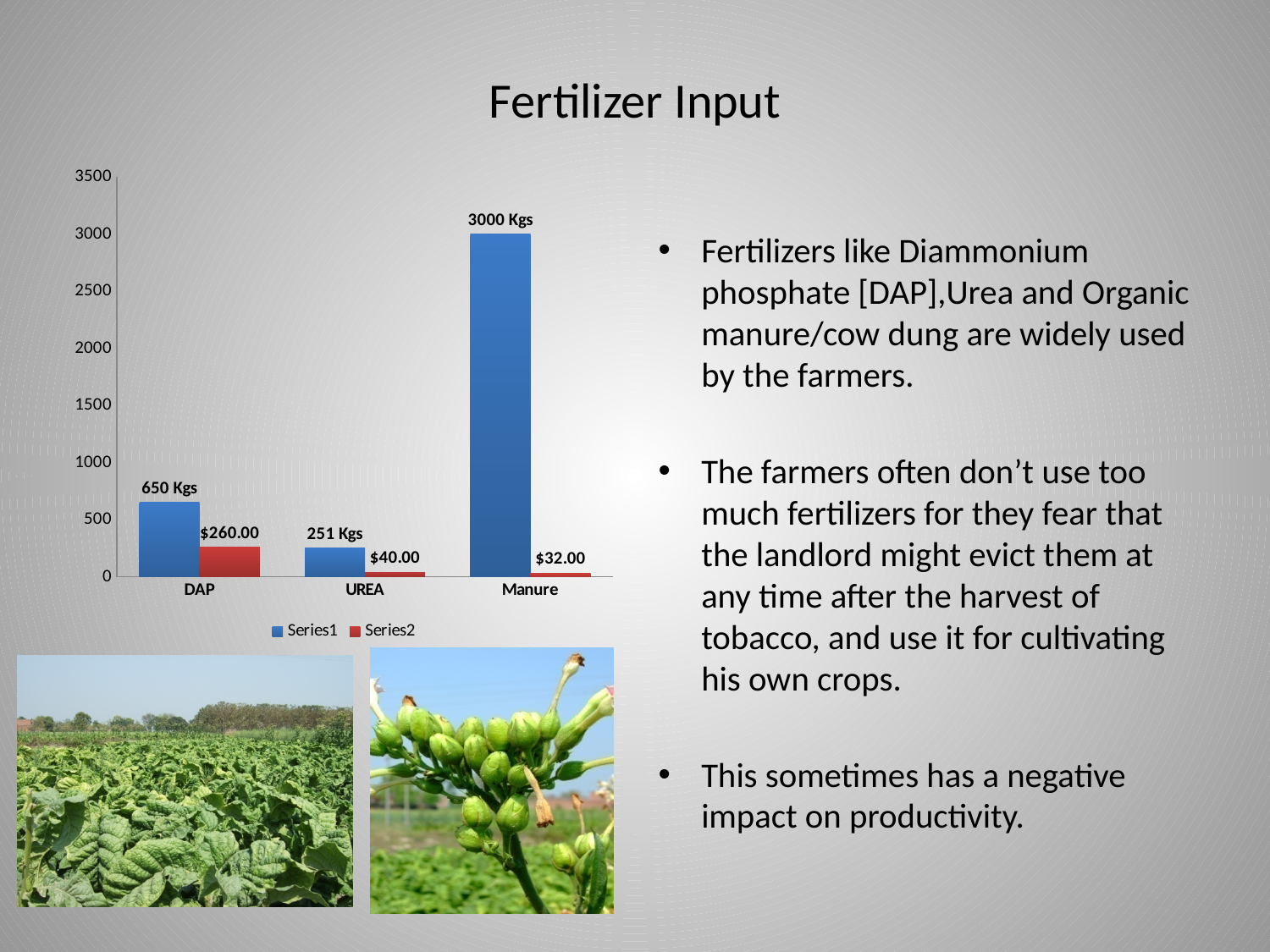
What is the difference between the Series1 values for DAP and UREA? 399 Kgs What is the Series2 value for Manure? $32.00 How many series does the legend list? 2 How many categories are shown on the x axis? 3 Is the Series1 value for DAP greater or less than 1000? less What is the Series1 value for Manure? 3000 Kgs Which category has the lowest Series2 value? Manure Which is larger, the Series2 value for UREA or for Manure? UREA What kind of chart is shown on the slide? bar chart What is the Series1 value for UREA? 251 Kgs What is the Series2 value for DAP? $260.00 Which category has the highest Series1 value? Manure